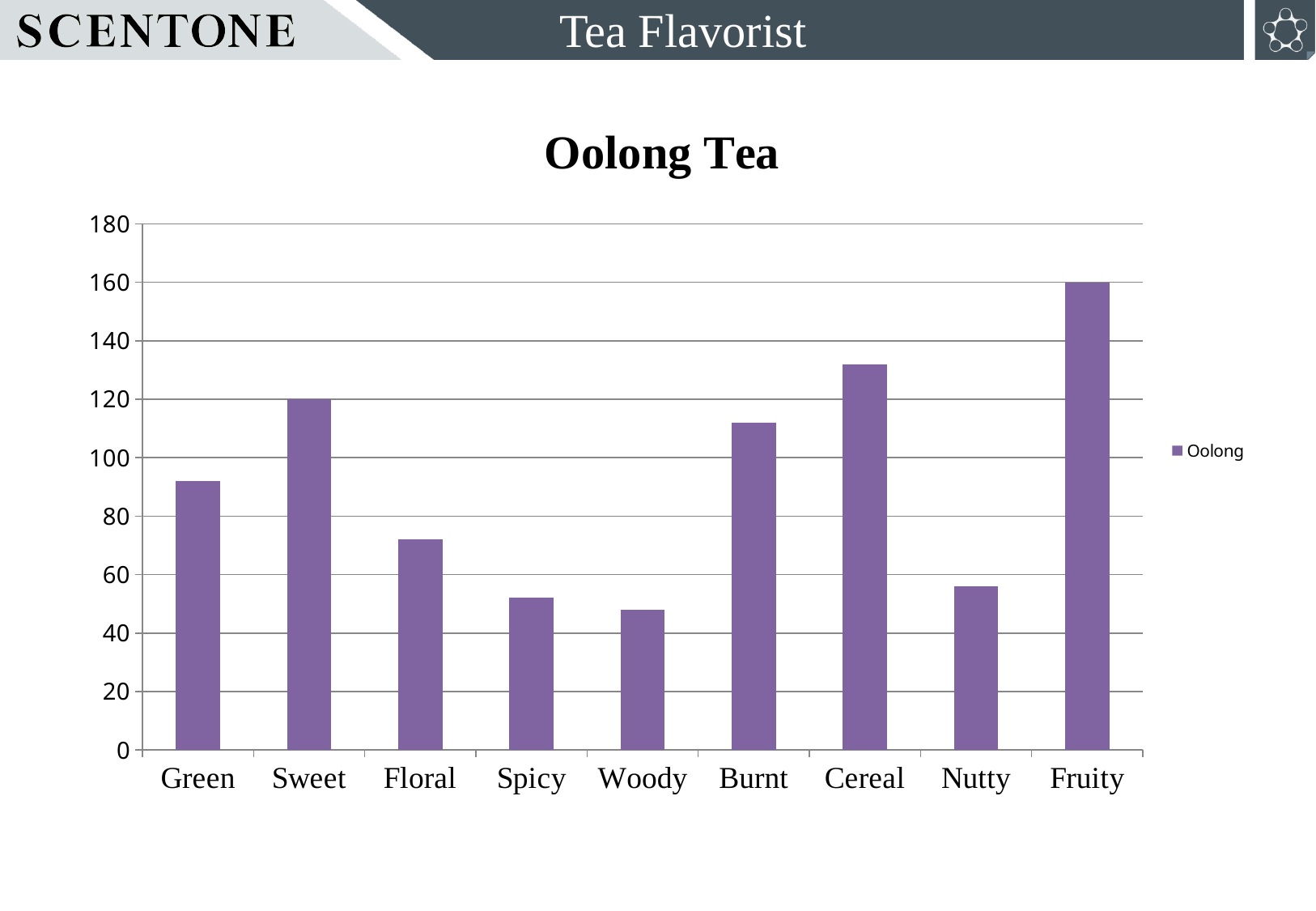
What is the value for Sweet? 120 Which is larger, the value for Floral or the value for Nutty? Floral Which is larger, the value for Cereal or the value for Burnt? Cereal What type of chart is shown on the slide? bar chart How many series does the legend list? 1 Is the value for Woody greater or less than 60? less What is the value for Fruity? 160 How many categories are shown on the x axis? 9 Is the value for Green greater or less than 100? less Is the value for Cereal greater or less than 120? greater Which category has the highest value? Fruity What is the title of the chart? Oolong Tea